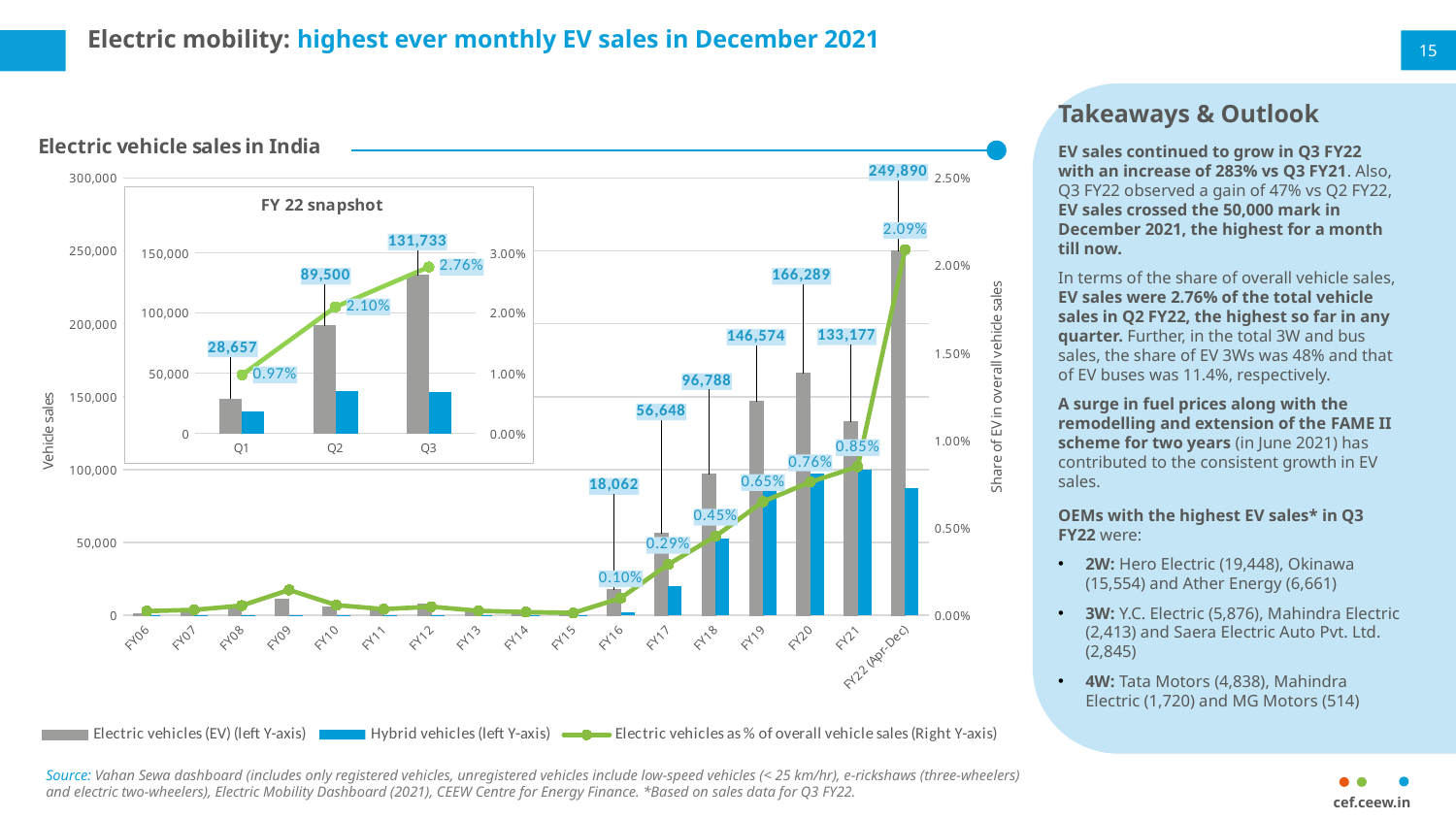
In the main chart 'Electric vehicle sales in India', what is the electric vehicle sales value labelled for FY22 (Apr-Dec)? 249,890 In the main chart 'Electric vehicle sales in India', how many series does the legend list? 3 In the main chart 'Electric vehicle sales in India', which fiscal year has the highest labelled electric vehicle sales? FY22 (Apr-Dec) In the inset 'FY 22 snapshot' chart, what share of overall vehicle sales did electric vehicles have in Q3? 2.76% In the inset 'FY 22 snapshot' chart, what is the difference between the electric vehicle sales labelled for Q3 and Q1? 103,076 In the main chart 'Electric vehicle sales in India', what is the difference between the electric vehicle sales labelled for FY20 and FY21? 33,112 In the inset 'FY 22 snapshot' chart, does the share of electric vehicles in overall vehicle sales rise or fall from Q1 to Q3? Rise In the inset 'FY 22 snapshot' chart, what is the electric vehicle sales value labelled for Q2? 89,500 In the main chart 'Electric vehicle sales in India', how many fiscal year categories are shown on the x-axis? 17 In the main chart 'Electric vehicle sales in India', what is the electric vehicle sales value labelled for FY19? 146,574 In the main chart 'Electric vehicle sales in India', what share of overall vehicle sales did electric vehicles have in FY21? 0.85% In the main chart 'Electric vehicle sales in India', which is larger: electric vehicle sales in FY18 or in FY21? FY21